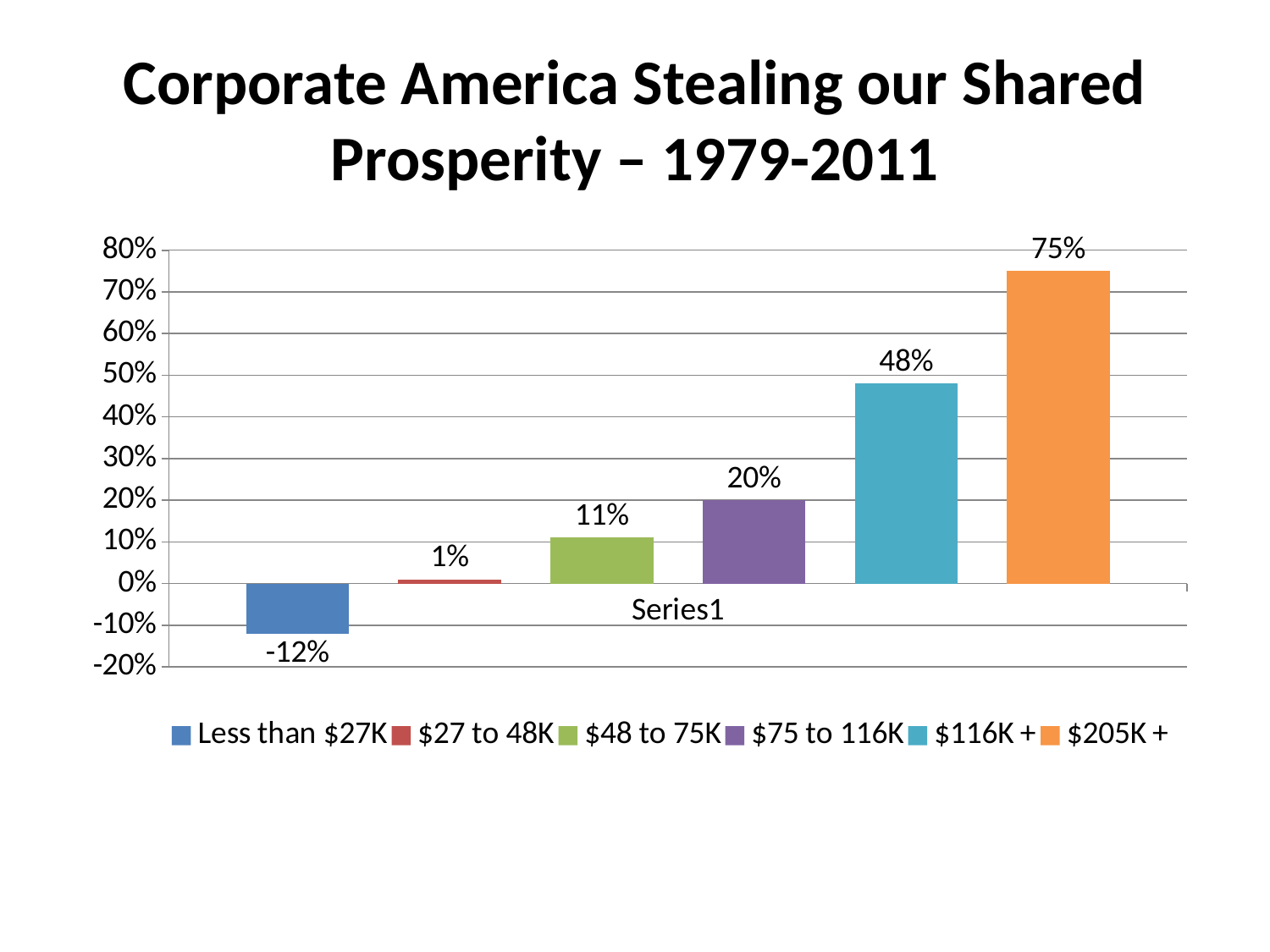
Do the values rise or fall from left to right across the income groups? rise Which income group has the lowest value? Less than $27K What kind of chart is shown on the slide? bar chart How many income groups are shown in the chart? 6 What is the value for the Less than $27K group? -12% What is the value for the $75 to 116K group? 20% Which income group has the highest value? $205K + What is the value for the $205K + group? 75% Which is larger, the value for $48 to 75K or the value for $75 to 116K? $75 to 116K What is the difference between the values for $205K + and $116K +? 27% What is the value for the $27 to 48K group? 1% Is the value for $116K + greater or less than 40%? greater